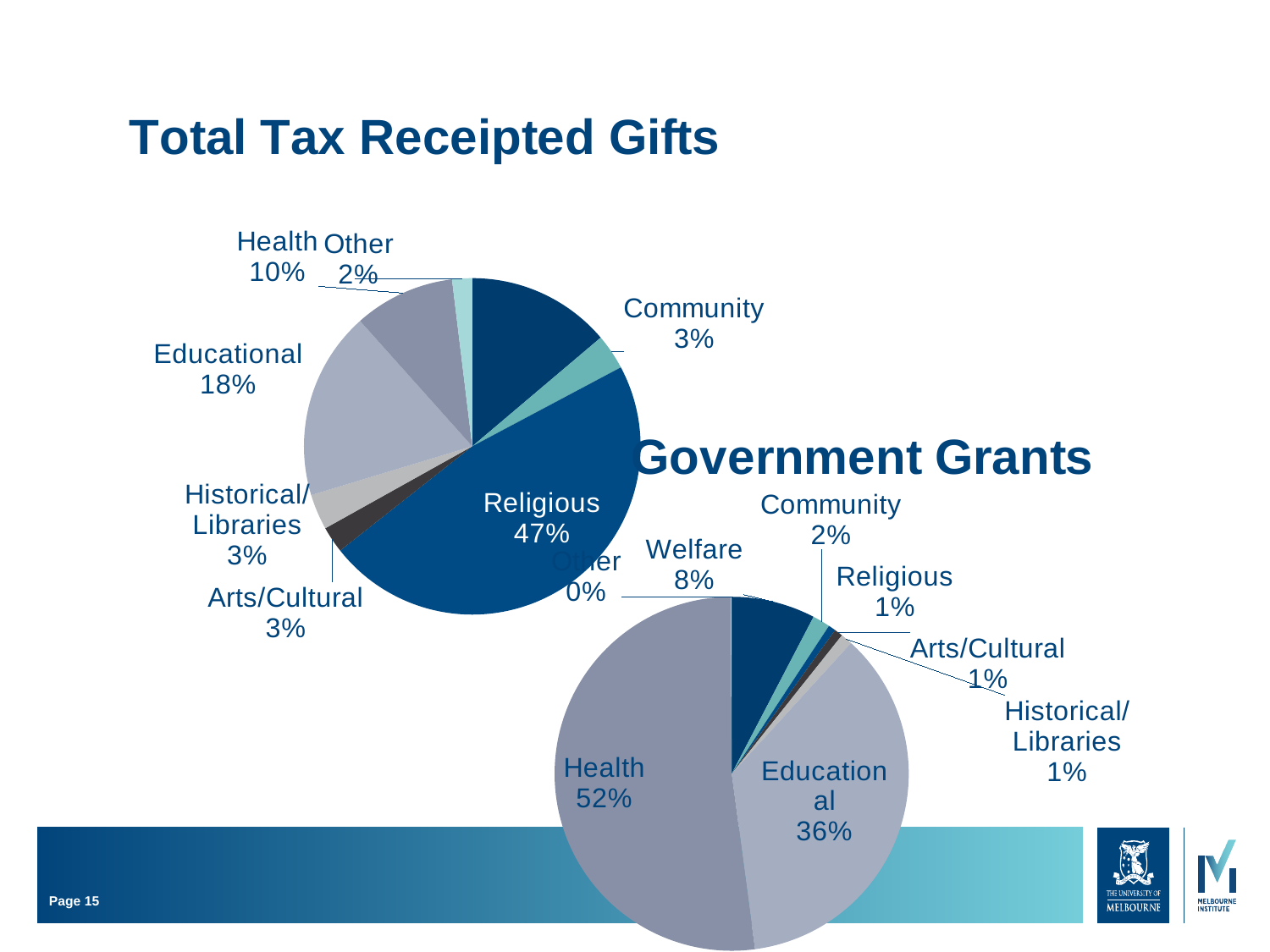
In the Government Grants pie chart, what share is Health? 52% In the Total Tax Receipted Gifts pie chart, which labelled category has the largest share? Religious In the Total Tax Receipted Gifts pie chart, what share is Educational? 18% In the Government Grants pie chart, how many categories are labelled? 8 In the Government Grants pie chart, which category has the largest share? Health In the Total Tax Receipted Gifts pie chart, what is the difference between the Educational and Health shares? 8% In the Total Tax Receipted Gifts pie chart, what share is Health? 10% In the Government Grants pie chart, what share is Educational? 36% In the Total Tax Receipted Gifts pie chart, what share is Religious? 47% In the Government Grants pie chart, what share is Welfare? 8% What type of chart is used for Government Grants? Pie chart In the Government Grants pie chart, which category has the smallest share? Other